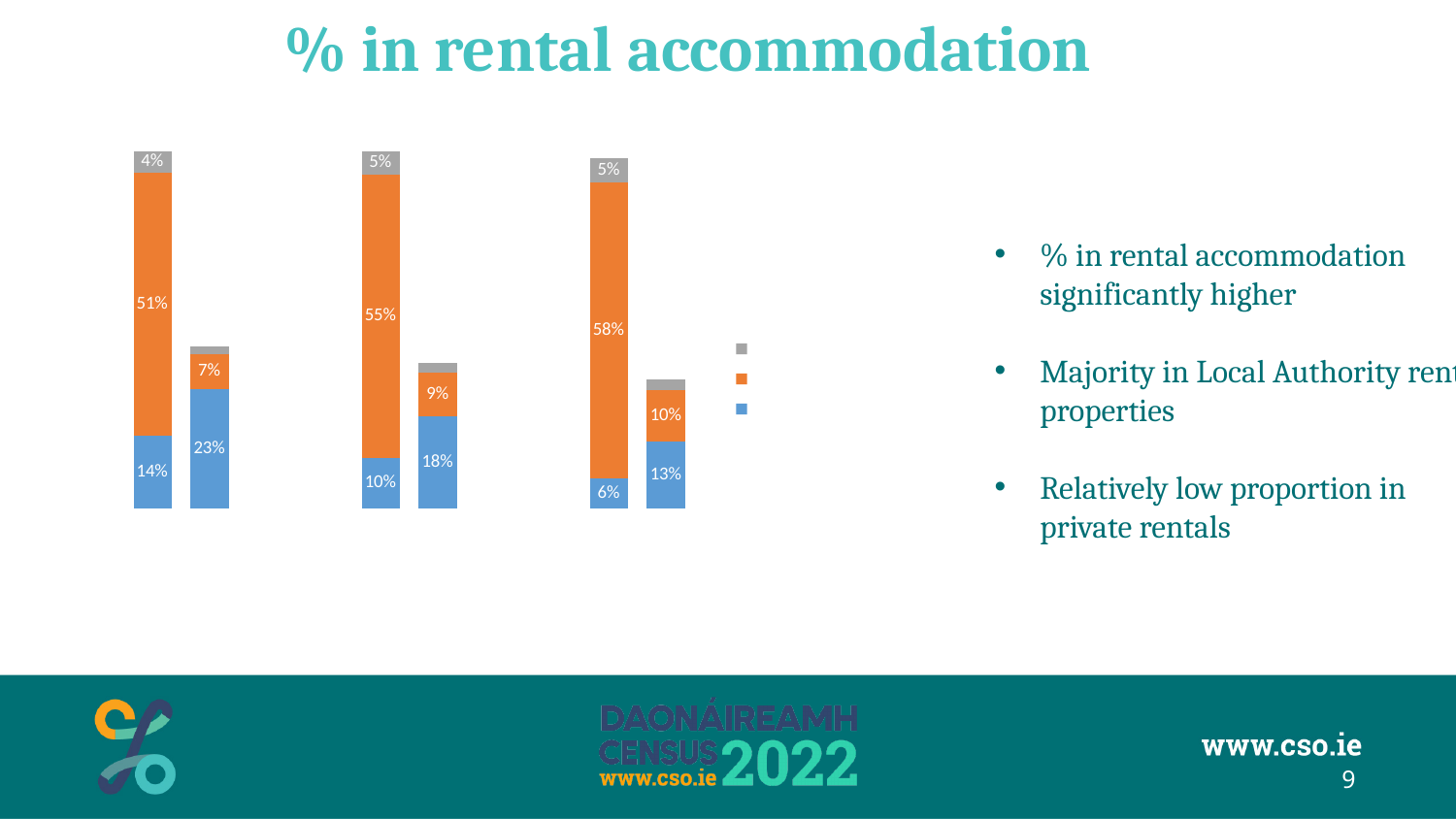
What is the title of the chart on the slide? % in rental accommodation What is the value of the orange segment in the leftmost bar of the chart? 51% What is the value of the orange segment in the second bar of the middle group? 9% Which bar has the largest orange segment, and what is its value? The tall bar in the rightmost group, 58% What is the value of the blue segment in the tallest bar of the rightmost group? 6% What kind of chart is shown on the slide? Stacked bar chart What is the total of the labelled segments in the leftmost bar (14%, 51%, 4%)? 69% How many series does the chart's legend list? 3 How many bars are plotted in the chart? 6 What is the difference between the orange segment of the tall bar in the middle group (55%) and the orange segment of the leftmost bar (51%)? 4 percentage points Which is larger: the blue segment of the second bar in the first group or the blue segment of the second bar in the third group? The second bar in the first group (23%) What is the smallest blue segment value shown in the chart? 6%